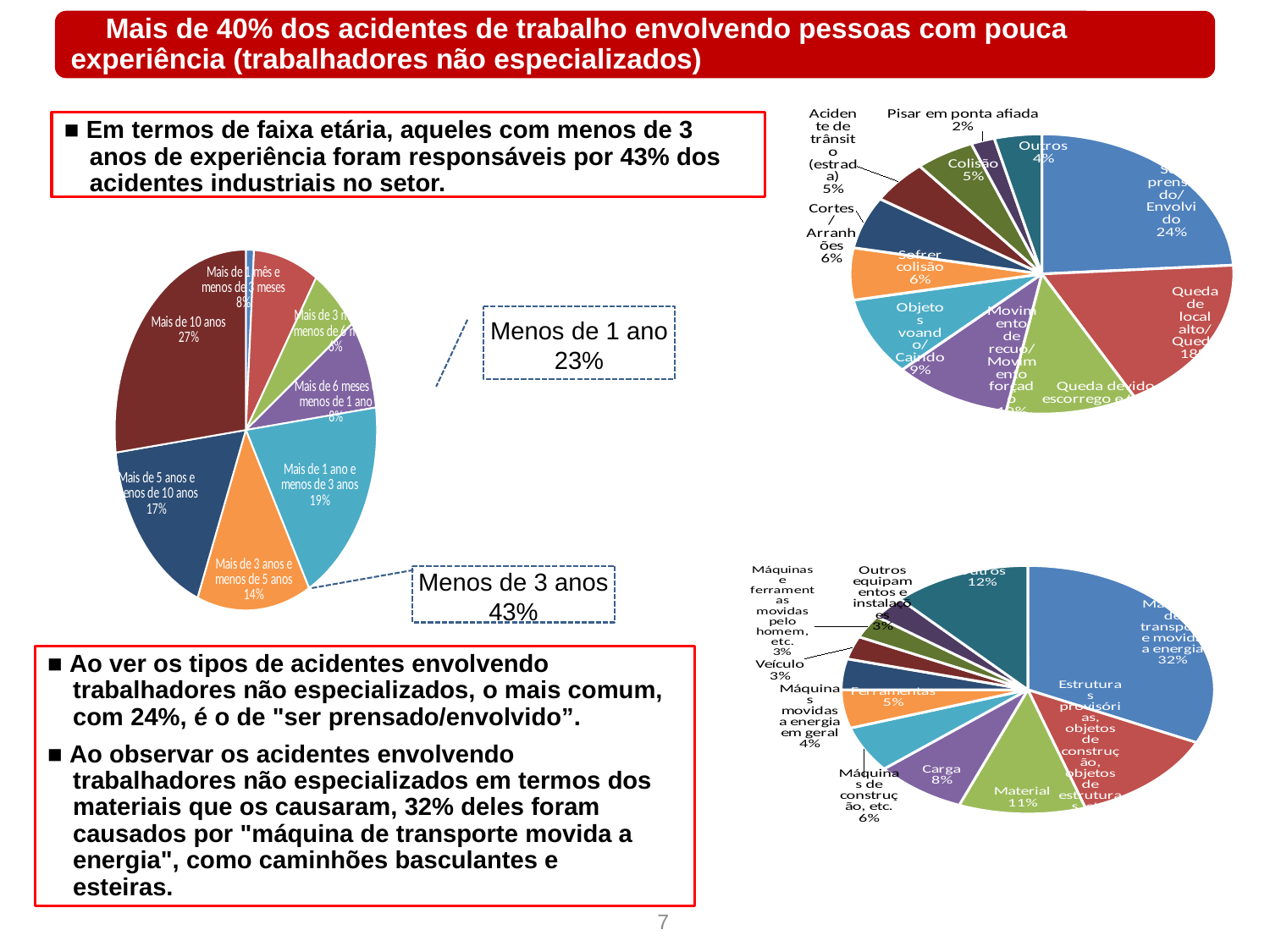
In the pie chart on the left, what share of accidents involved workers with more than 10 years of experience (Mais de 10 anos)? 27% In the pie chart on the left, which is larger: 'Mais de 5 anos e menos de 10 anos' or 'Mais de 3 anos e menos de 5 anos'? Mais de 5 anos e menos de 10 anos In the top-right pie chart, what share is shown for 'Pisar em ponta afiada'? 2% In the pie chart on the left, what is the difference between the shares for 'Mais de 10 anos' and 'Mais de 3 anos e menos de 5 anos'? 13 percentage points In the top-right pie chart, what share is shown for 'Objetos voando/Caindo'? 9% In the top-right pie chart, what is the difference between 'Ser prensado/Envolvido' and 'Queda de local alto/Queda'? 6 percentage points In the top-right pie chart, which accident type has the largest share? Ser prensado/Envolvido In the pie chart on the left, what percentage does the callout give for 'Menos de 1 ano'? 23% In the bottom-right pie chart, which is larger: 'Material' or 'Carga'? Material In the pie chart on the left, what share is shown for 'Mais de 1 ano e menos de 3 anos'? 19% In the bottom-right pie chart, what share is shown for 'Máquina de transporte movida a energia'? 32% What type of chart is used for the three charts on this slide? Pie chart